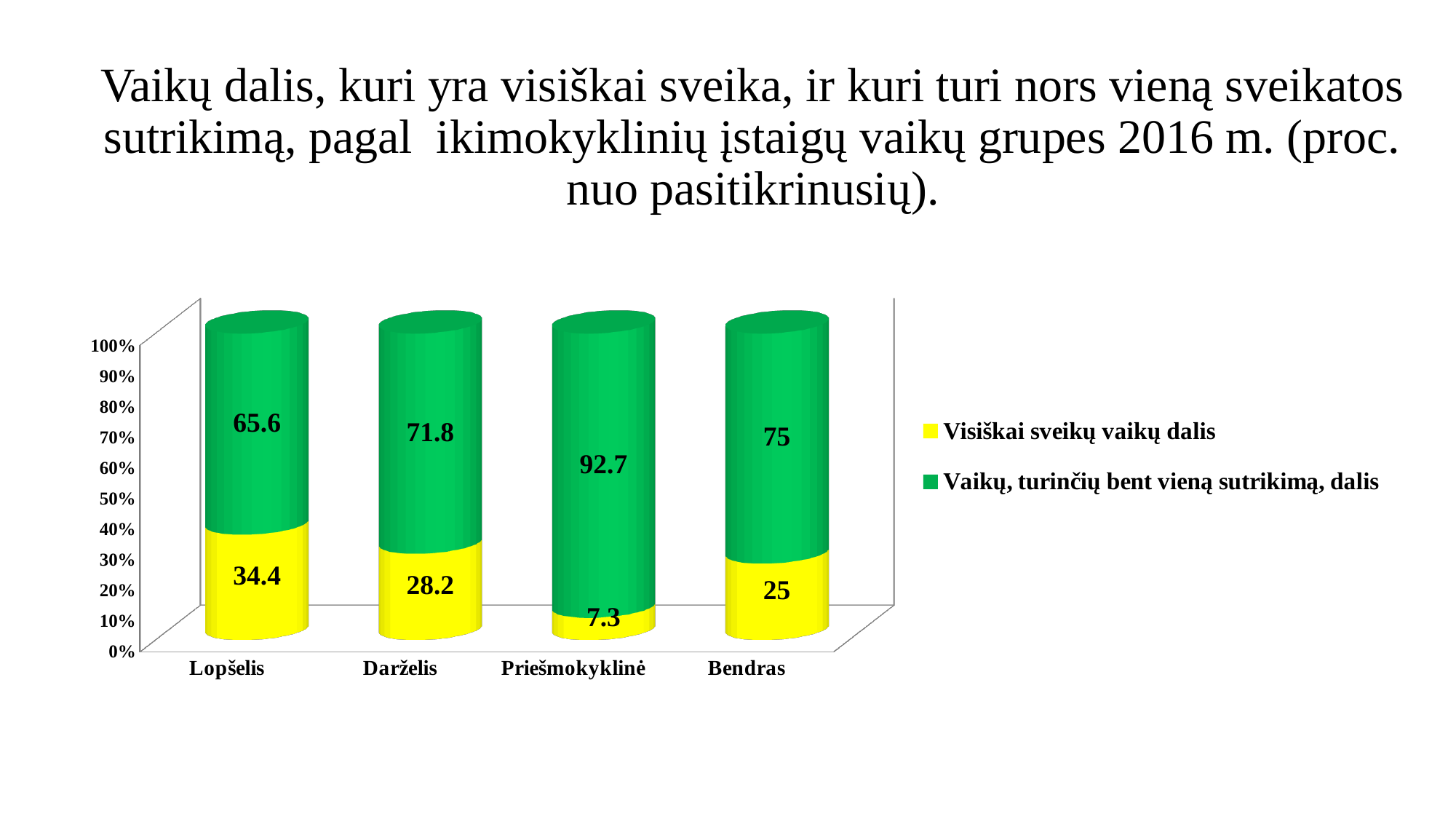
How many series does the legend list? 2 Which category has the lowest value for 'Visiškai sveikų vaikų dalis'? Priešmokyklinė Which colour represents 'Visiškai sveikų vaikų dalis' in the chart? Yellow What is the value of 'Visiškai sveikų vaikų dalis' for Bendras? 25 Which is larger: the 'Visiškai sveikų vaikų dalis' value for Darželis or for Bendras? Darželis What is the difference between the 'Visiškai sveikų vaikų dalis' values for Lopšelis and Darželis? 6.2 What is the value of 'Vaikų, turinčių bent vieną sutrikimą, dalis' for Priešmokyklinė? 92.7 Which category has the highest value for 'Vaikų, turinčių bent vieną sutrikimą, dalis'? Priešmokyklinė What is the value of 'Vaikų, turinčių bent vieną sutrikimą, dalis' for Darželis? 71.8 What is the value of 'Visiškai sveikų vaikų dalis' for Lopšelis? 34.4 What kind of chart is shown on the slide? Stacked bar chart How many categories are shown on the x axis? 4